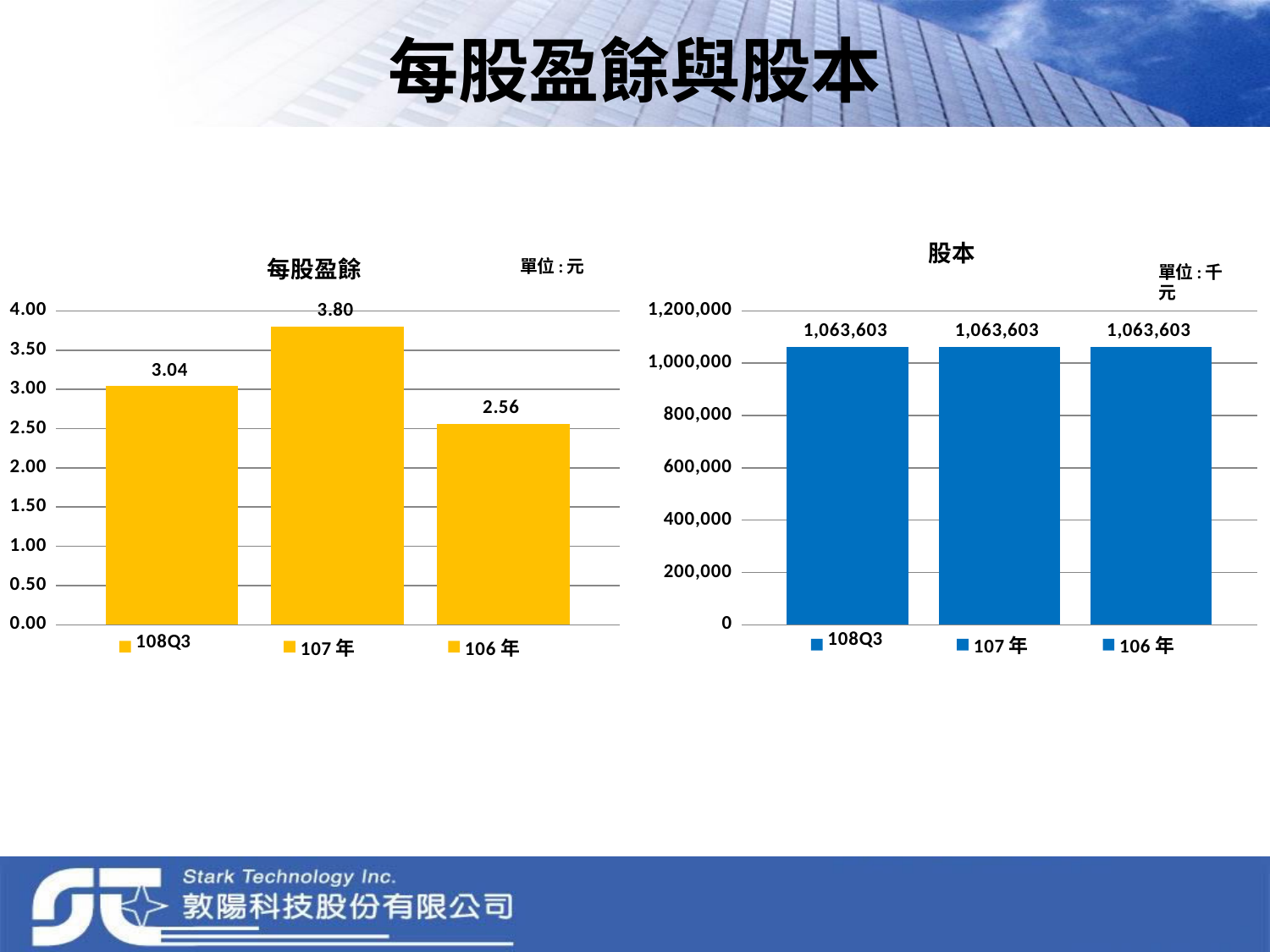
In the 每股盈餘 chart, what is the value for 107 年? 3.80 What kind of chart is the 股本 chart? bar chart What unit is shown for the 每股盈餘 chart? 元 In the 股本 chart, how many entries does the legend list? 3 In the 每股盈餘 chart, how many bars are plotted? 3 In the 每股盈餘 chart, what is the value for 108Q3? 3.04 In the 每股盈餘 chart, which is larger, the value for 108Q3 or the value for 106 年? 108Q3 In the 每股盈餘 chart, which category has the lowest value? 106 年 In the 股本 chart, what is the value for 106 年? 1,063,603 In the 每股盈餘 chart, which category has the highest value? 107 年 In the 股本 chart, is the value for 107 年 greater or less than 1,000,000? greater In the 每股盈餘 chart, what is the difference between the values for 107 年 and 106 年? 1.24